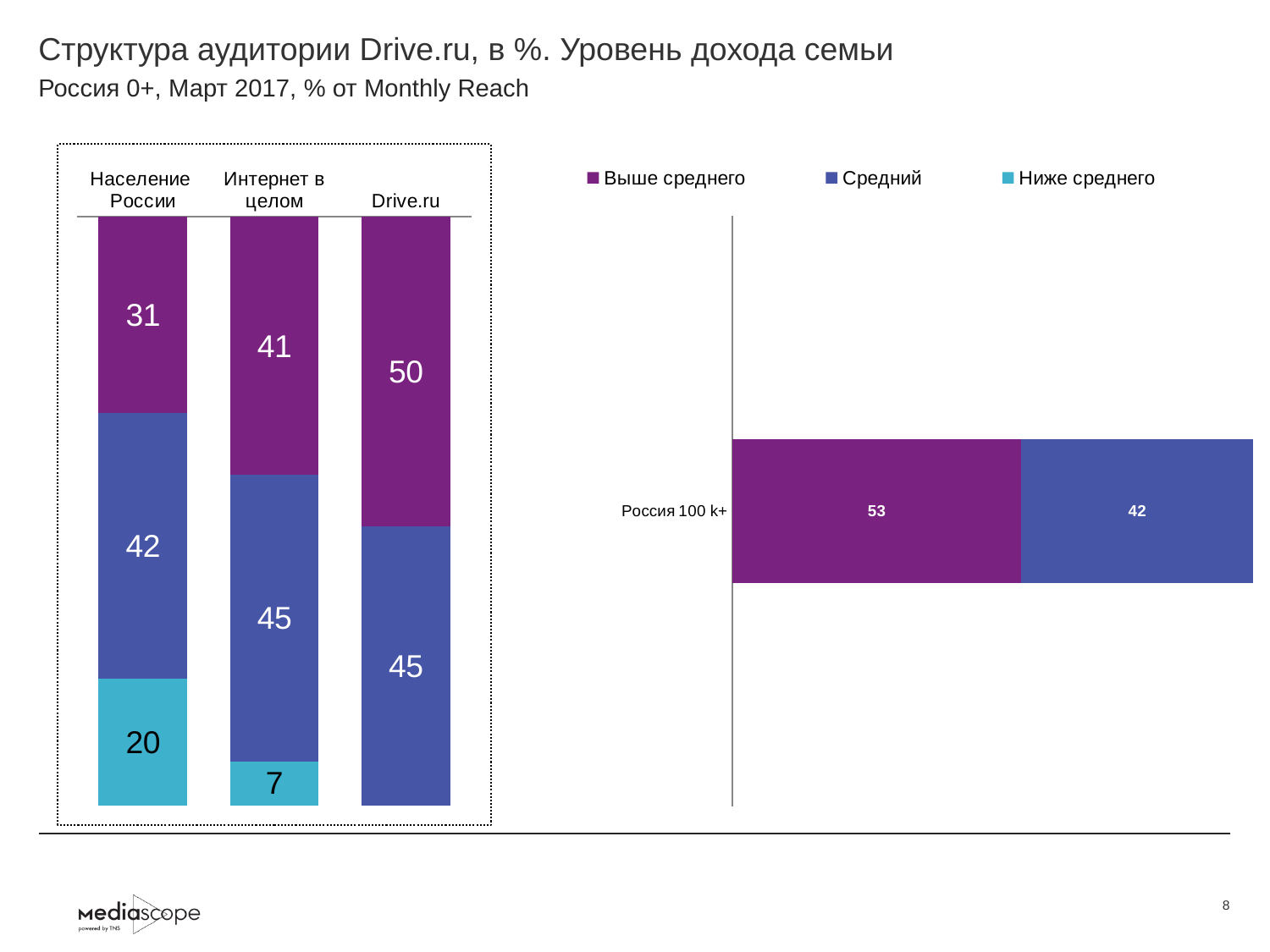
In the right chart, what is the 'Выше среднего' value for Россия 100 k+? 53 How many categories are shown in the left chart? 3 In the left chart, what is the value of the 'Средний' segment for Интернет в целом? 45 In the left chart, what is the value of the 'Ниже среднего' segment for Население России? 20 In the left chart, which category has the lowest 'Ниже среднего' value among those labelled? Интернет в целом In the left chart, what is the difference between the 'Выше среднего' values for Drive.ru and Население России? 19 In the right chart, what is the total of the two labelled segments for Россия 100 k+? 95 In the left chart, which is larger: the 'Ниже среднего' value for Население России or for Интернет в целом? Население России How many series does the legend list? 3 In the left chart, which category has the highest 'Выше среднего' value? Drive.ru In the left chart, what is the value of the 'Выше среднего' segment for Drive.ru? 50 What kind of chart is the chart on the right? Stacked bar chart